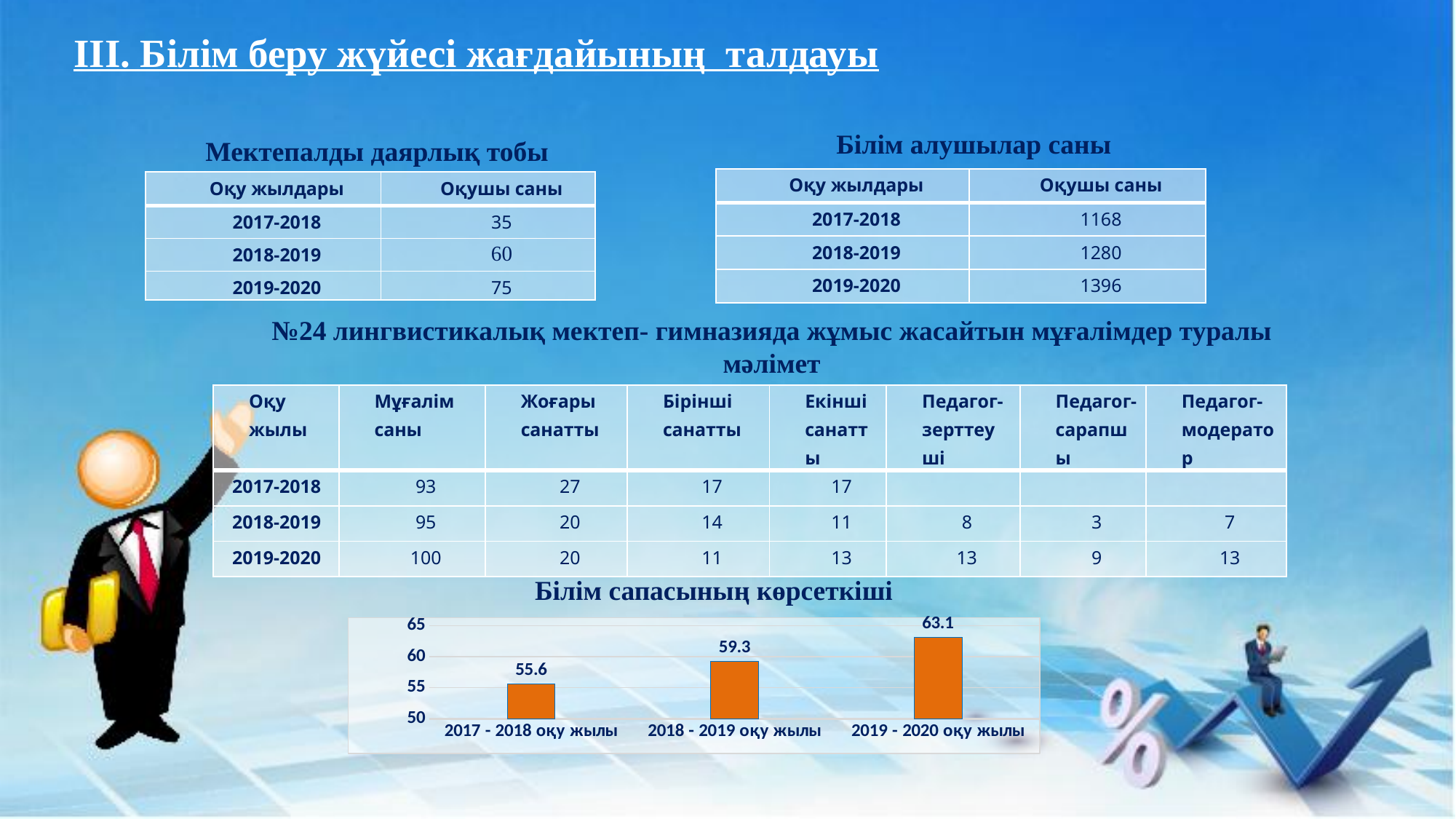
What is the value for 2017 - 2018 оқу жылы in the chart? 55.6 What is the value for 2018 - 2019 оқу жылы in the chart? 59.3 Which school year has the highest value in the chart? 2019 - 2020 оқу жылы What is the difference between the values for 2018 - 2019 оқу жылы and 2017 - 2018 оқу жылы? 3.7 Which school year has the lowest value in the chart? 2017 - 2018 оқу жылы How many bars are shown in the chart? 3 Which is larger: the value for 2018 - 2019 оқу жылы or 2019 - 2020 оқу жылы? 2019 - 2020 оқу жылы Do the values in the chart rise or fall from 2017 - 2018 to 2019 - 2020? rise What kind of chart is shown on the slide? bar chart What is the difference between the values for 2019 - 2020 оқу жылы and 2017 - 2018 оқу жылы? 7.5 What is the value for 2019 - 2020 оқу жылы in the chart? 63.1 Is the value for 2018 - 2019 оқу жылы greater or less than 60? less